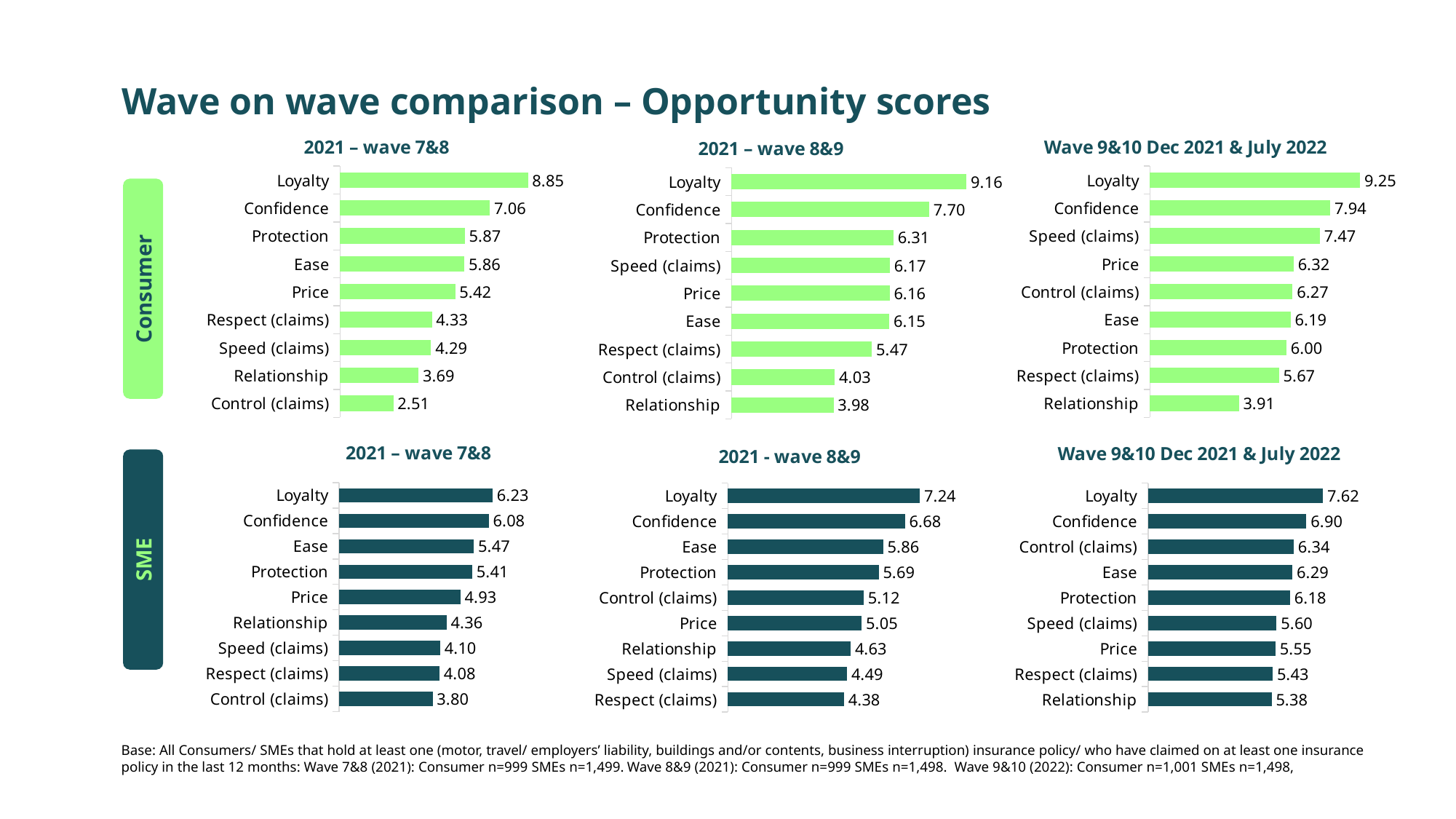
In the SME 2021 - wave 8&9 chart, what is the value for Control (claims)? 5.12 How many charts are shown on the slide? 6 In the Consumer 2021 – wave 8&9 chart, what is the difference between Loyalty and Relationship? 5.18 What type of chart is the Consumer 2021 – wave 8&9 chart? Bar chart In the SME Wave 9&10 Dec 2021 & July 2022 chart, what is the value for Relationship? 5.38 How many categories are shown in the SME 2021 - wave 8&9 chart? 9 In the Consumer Wave 9&10 Dec 2021 & July 2022 chart, what is the value for Speed (claims)? 7.47 In the SME Wave 9&10 Dec 2021 & July 2022 chart, which category has the highest value? Loyalty In the Consumer Wave 9&10 Dec 2021 & July 2022 chart, which is larger: Price or Protection? Price In the Consumer 2021 – wave 7&8 chart, which category has the lowest value? Control (claims) In the Consumer 2021 – wave 7&8 chart, what is the value for Loyalty? 8.85 In the SME 2021 – wave 7&8 chart, what is the difference between Loyalty and Confidence? 0.15